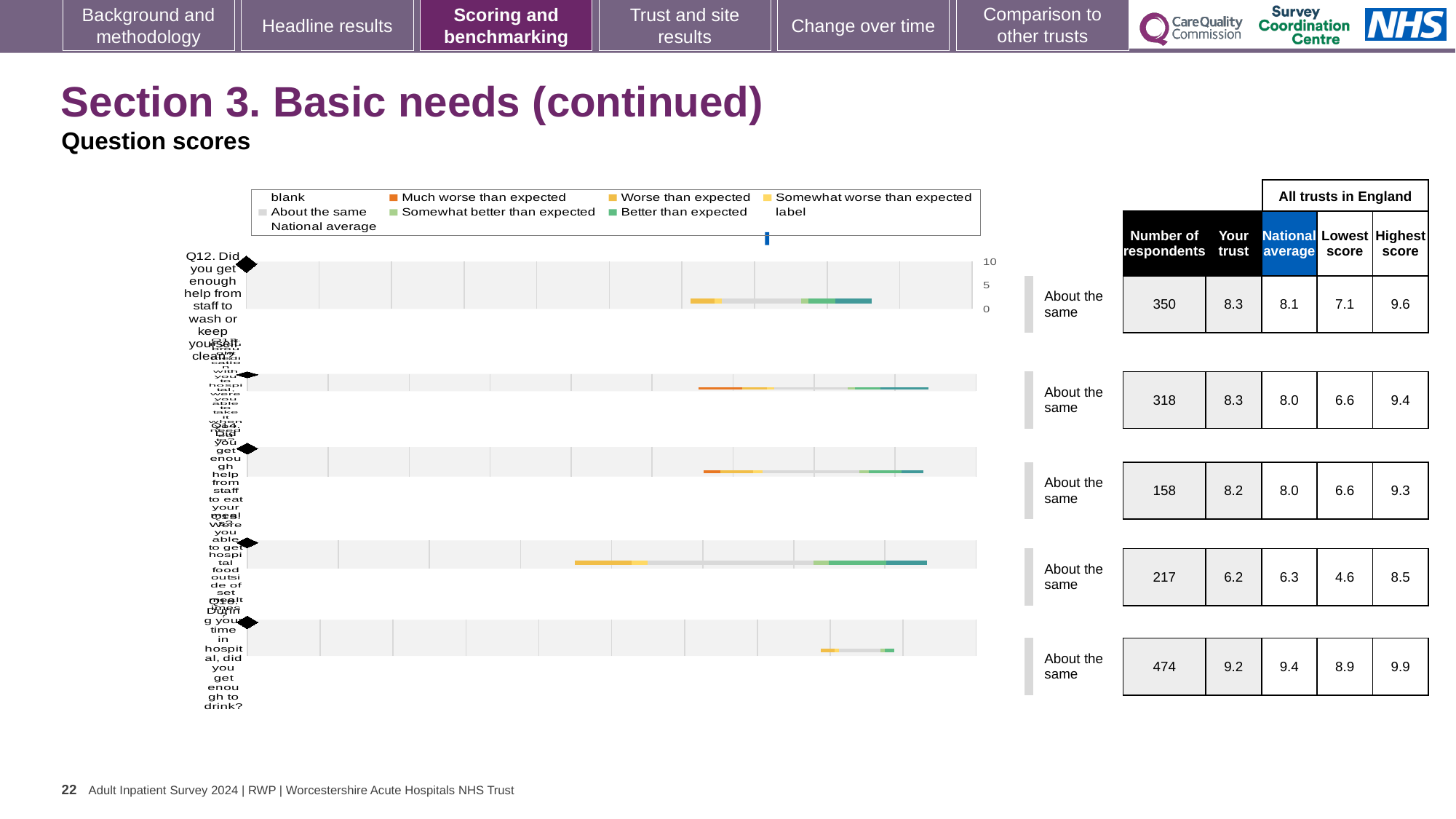
In the table beside the chart, what is the difference between the highest score and the lowest score for Q12? 2.5 In the table beside the chart, is the 'Your trust' score for Q12 larger or smaller than the national average? larger In the table beside the chart, what is the number of respondents for Q12 (help from staff to wash or keep yourself clean)? 350 In the table beside the chart, which row has the highest number of respondents? the fifth row (474) What benchmark category is shown next to the first bar (Q12) in the chart? About the same In the table beside the chart, what is the 'Your trust' score for Q12? 8.3 In the chart legend, which colour represents 'Much worse than expected'? orange How many question rows (bars) does the chart show? 5 In the chart legend, which colour represents 'Better than expected'? green In the table beside the chart, which row has the lowest 'Your trust' score? the fourth row (6.2) In the table beside the chart, what is the national average for Q12? 8.1 What kind of chart is shown on the slide? bar chart